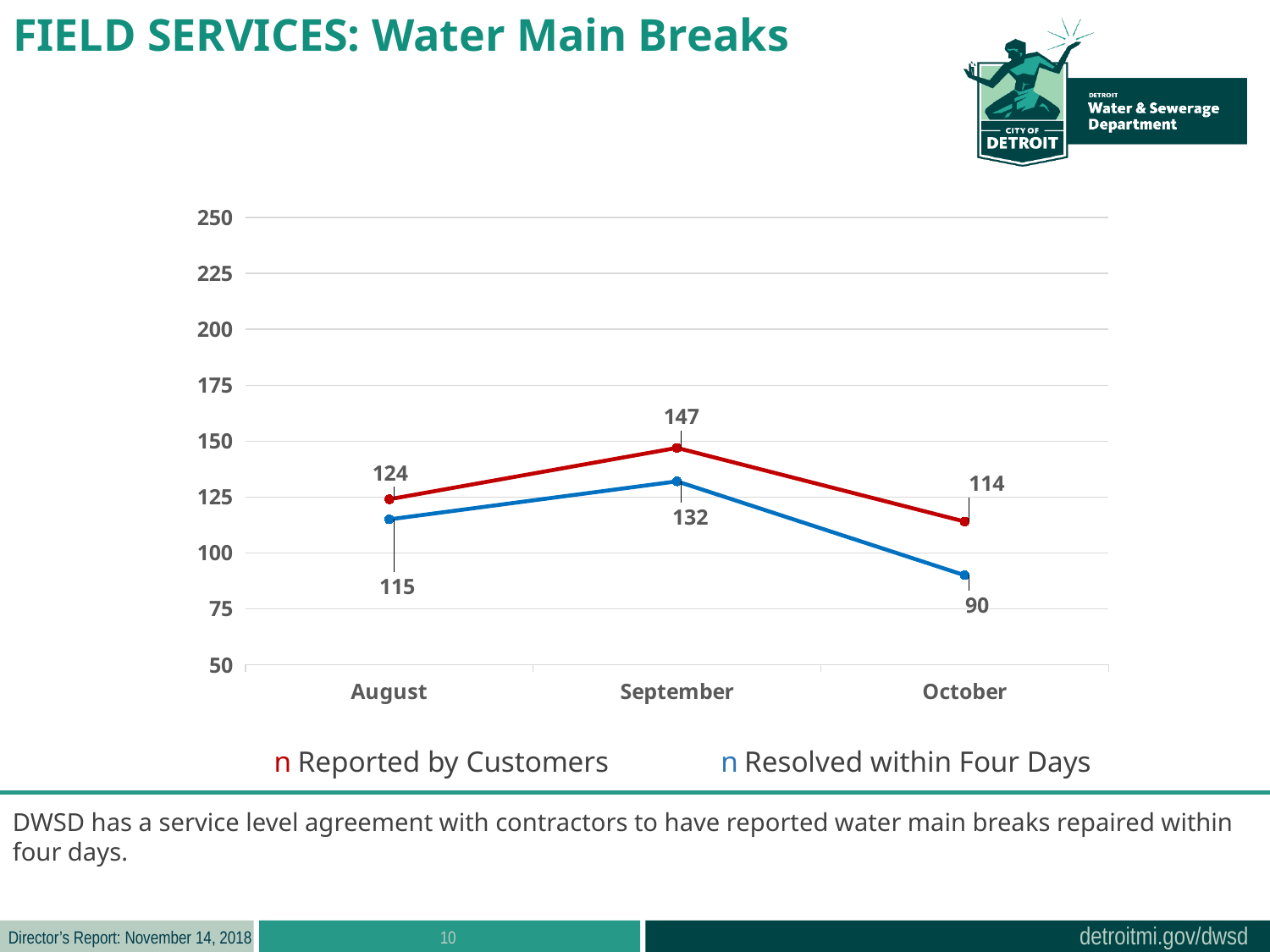
What is the value for Resolved within Four Days in October? 90 In which month is the Resolved within Four Days value lowest? October What is the difference between Reported by Customers and Resolved within Four Days in October? 24 Which is larger in September: Reported by Customers or Resolved within Four Days? Reported by Customers How many series does the legend list? 2 What is the value for Reported by Customers in August? 124 What kind of chart is shown on the slide? line chart How many months are shown on the x axis? 3 What is the value for Reported by Customers in September? 147 Is the value for Resolved within Four Days in August greater or less than 125? less In which month is the Reported by Customers value highest? September Does the Resolved within Four Days series rise or fall from September to October? fall